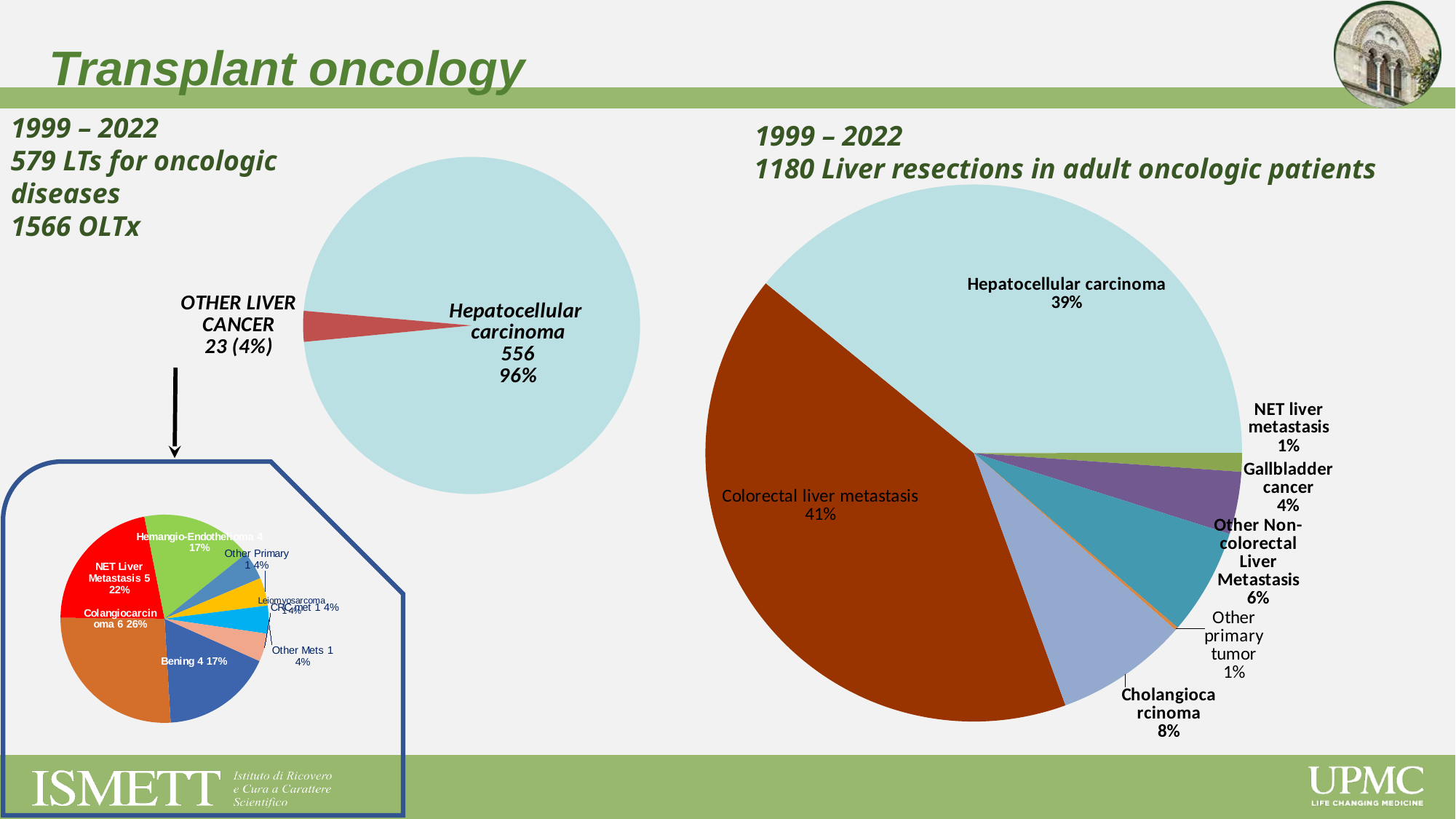
In the liver resections pie chart on the right, which category has the largest share? Colorectal liver metastasis In the liver transplant pie chart in the upper middle of the slide, what share is labelled for OTHER LIVER CANCER? 4% In the small pie chart at the bottom left, how many cases are shown for NET Liver Metastasis? 5 In the liver resections pie chart on the right, how many percentage points larger is Hepatocellular carcinoma than Cholangiocarcinoma? 31 percentage points How many categories are shown in the small pie chart at the bottom left? 8 In the small pie chart at the bottom left, which category has the largest share? Colangiocarcinoma In the liver resections pie chart on the right, which is larger: Gallbladder cancer or Other Non-colorectal Liver Metastasis? Other Non-colorectal Liver Metastasis What type of chart is used for the liver transplant data in the upper middle of the slide? Pie chart In the liver resections pie chart on the right, what percentage is shown for Cholangiocarcinoma? 8% In the liver transplant pie chart in the upper middle of the slide, how many Hepatocellular carcinoma cases are shown? 556 In the liver resections pie chart on the right, what share is labelled for Colorectal liver metastasis? 41% How many categories are labelled in the liver resections pie chart on the right? 7